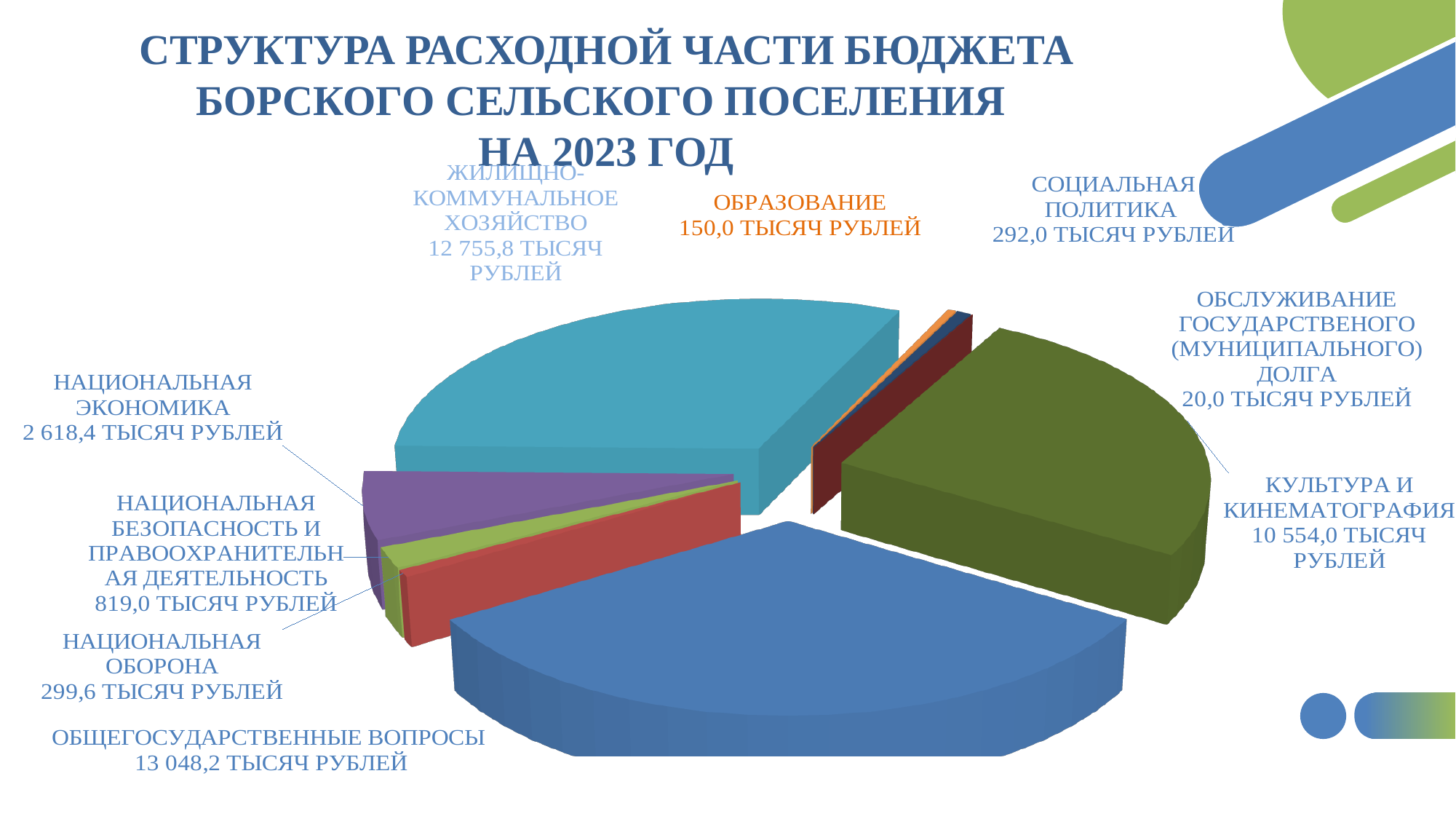
What is the value for КУЛЬТУРА И КИНЕМАТОГРАФИЯ? 10 554,0 тысяч рублей What is the value for ЖИЛИЩНО-КОММУНАЛЬНОЕ ХОЗЯЙСТВО? 12 755,8 тысяч рублей Which category has the largest value in the pie chart? ОБЩЕГОСУДАРСТВЕННЫЕ ВОПРОСЫ What is the difference between НАЦИОНАЛЬНАЯ ЭКОНОМИКА and НАЦИОНАЛЬНАЯ БЕЗОПАСНОСТЬ И ПРАВООХРАНИТЕЛЬНАЯ ДЕЯТЕЛЬНОСТЬ? 1 799,4 тысяч рублей What is the value for НАЦИОНАЛЬНАЯ БЕЗОПАСНОСТЬ И ПРАВООХРАНИТЕЛЬНАЯ ДЕЯТЕЛЬНОСТЬ? 819,0 тысяч рублей What kind of chart is shown on the slide? Pie chart Which is larger: ЖИЛИЩНО-КОММУНАЛЬНОЕ ХОЗЯЙСТВО or КУЛЬТУРА И КИНЕМАТОГРАФИЯ? ЖИЛИЩНО-КОММУНАЛЬНОЕ ХОЗЯЙСТВО What is the title of the chart on the slide? СТРУКТУРА РАСХОДНОЙ ЧАСТИ БЮДЖЕТА БОРСКОГО СЕЛЬСКОГО ПОСЕЛЕНИЯ НА 2023 ГОД What is the difference between ОБЩЕГОСУДАРСТВЕННЫЕ ВОПРОСЫ and ЖИЛИЩНО-КОММУНАЛЬНОЕ ХОЗЯЙСТВО? 292,4 тысяч рублей How many categories (slices) does the pie chart show? 9 What is the value for ОБЩЕГОСУДАРСТВЕННЫЕ ВОПРОСЫ? 13 048,2 тысяч рублей Which category has the smallest value in the pie chart? ОБСЛУЖИВАНИЕ ГОСУДАРСТВЕНОГО (МУНИЦИПАЛЬНОГО) ДОЛГА